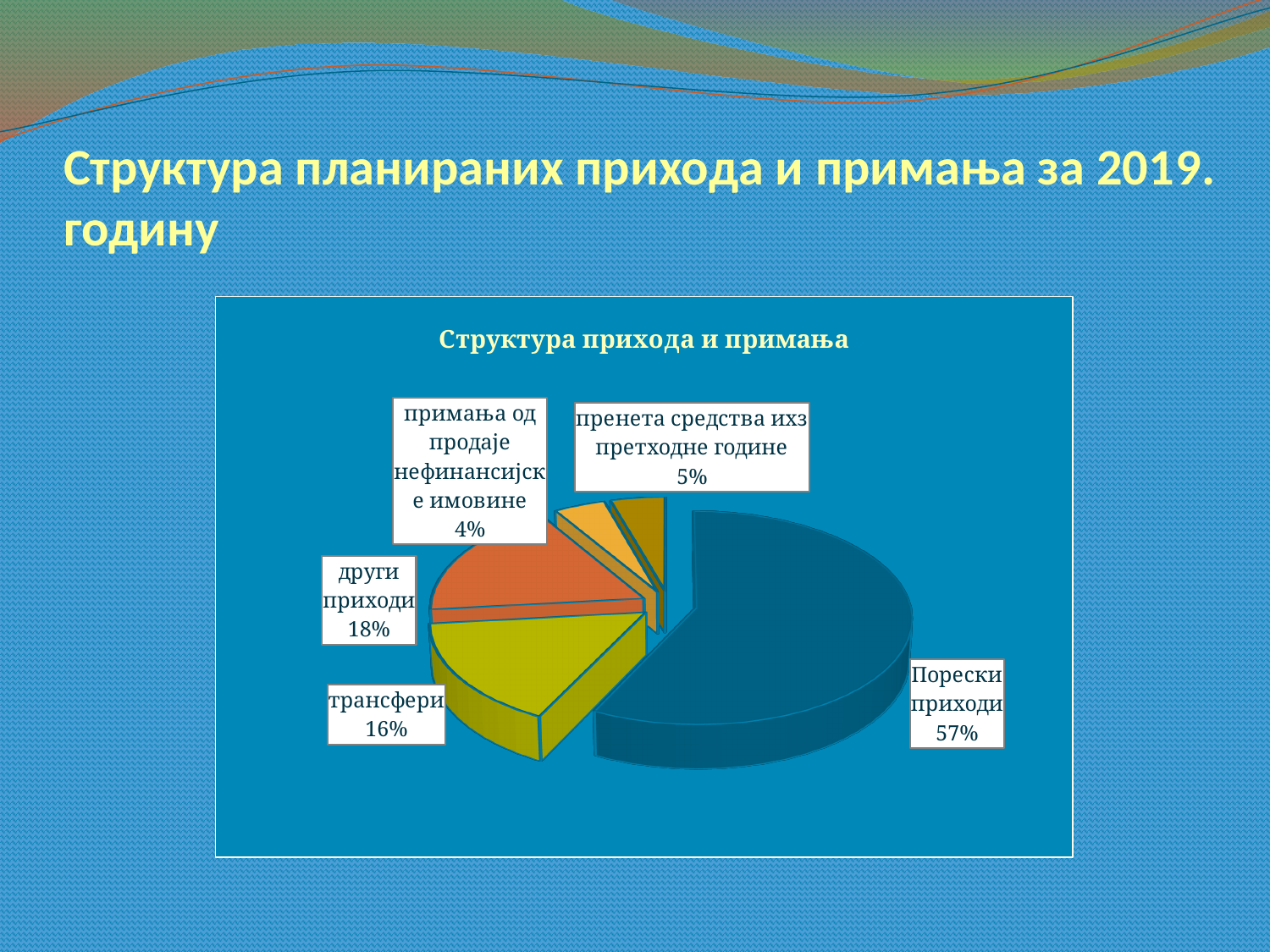
What is the difference in percentage points between "Порески приходи" and "други приходи"? 39 How many slices does the pie chart have? 5 Which is larger, the share for "други приходи" or the share for "трансфери"? други приходи What is the title of the chart? Структура прихода и примања What share of the pie is labelled "трансфери"? 16% What kind of chart is shown on the slide? pie chart Which slice of the pie is the largest? Порески приходи What share of the pie is labelled "други приходи"? 18% What share of the pie is labelled "пренета средства из претходне године"? 5% Which slice of the pie is the smallest? примања од продаје нефинансијске имовине What share of the pie is labelled "примања од продаје нефинансијске имовине"? 4% What share of the pie is labelled "Порески приходи"? 57%